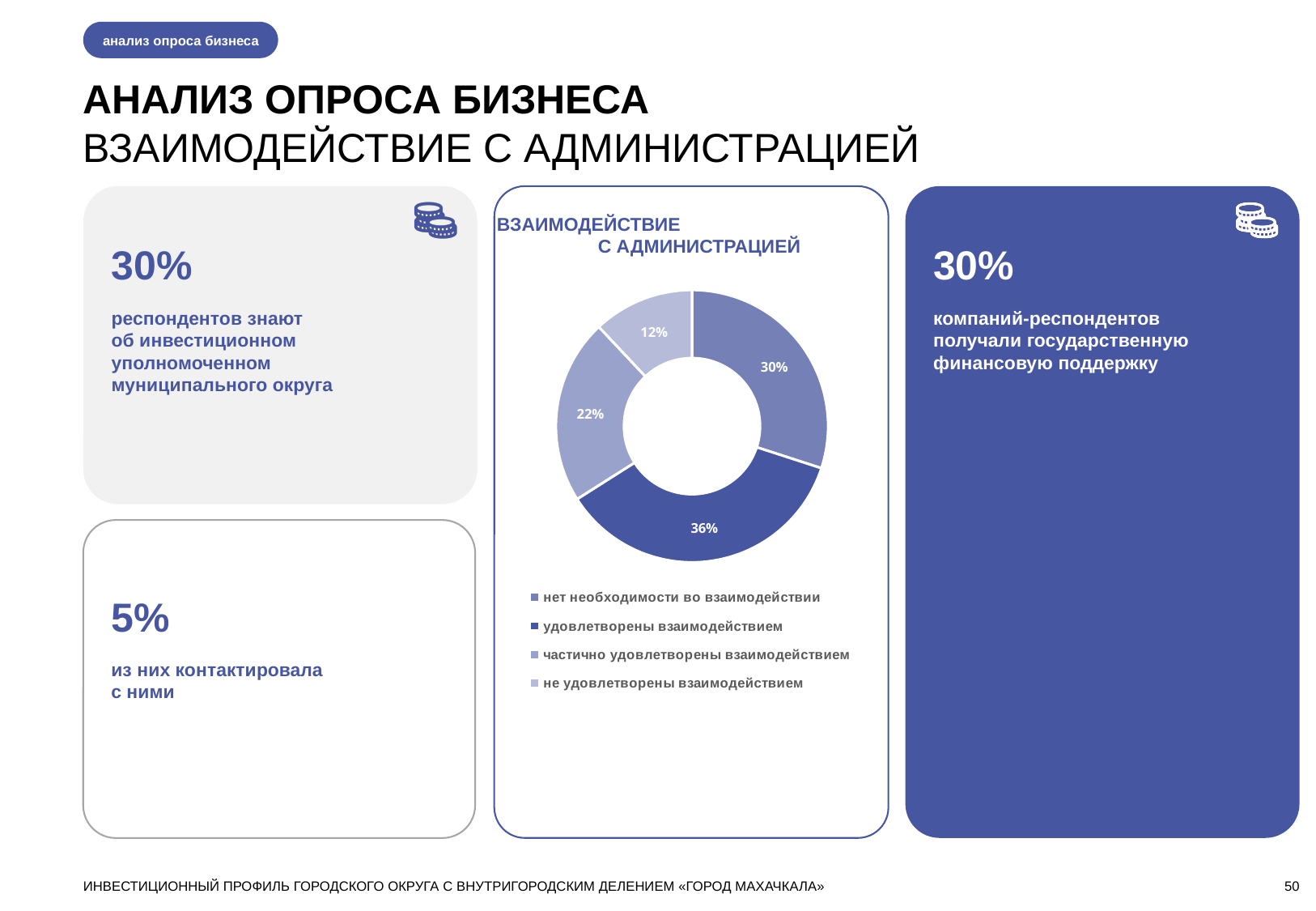
How many entries does the chart legend list? 4 Which is larger: the share for 'нет необходимости во взаимодействии' or for 'частично удовлетворены взаимодействием'? нет необходимости во взаимодействии What share of respondents are 'не удовлетворены взаимодействием'? 12% Which category has the smallest share in the chart? не удовлетворены взаимодействием How many slices does the chart have? 4 What type of chart is shown on the slide? pie chart (donut) What is the difference in percentage points between 'удовлетворены взаимодействием' and 'не удовлетворены взаимодействием'? 24 What share of respondents answered 'нет необходимости во взаимодействии'? 30% What is the title of the chart? ВЗАИМОДЕЙСТВИЕ С АДМИНИСТРАЦИЕЙ What share of respondents are 'удовлетворены взаимодействием'? 36% What share of respondents are 'частично удовлетворены взаимодействием'? 22% Which category has the largest share in the chart? удовлетворены взаимодействием